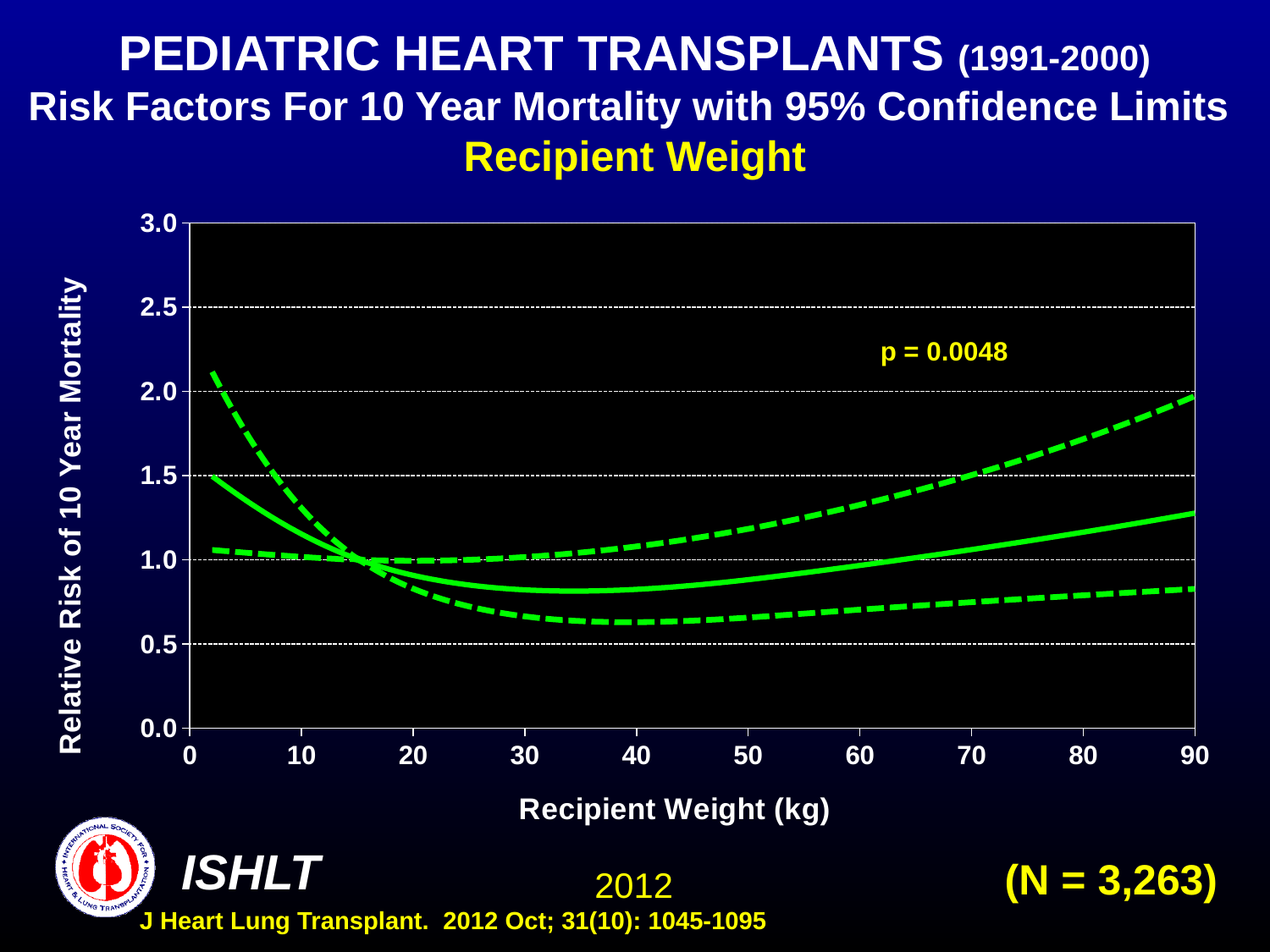
What kind of chart is shown on the slide? line chart Is the relative risk on the solid line at a recipient weight of 90 kg greater or less than 1.0? greater Does the solid relative risk line rise or fall as recipient weight increases from 40 to 90 kg? rise How many lines are plotted on the chart? 3 Is the lower dashed confidence limit at a recipient weight of 40 kg greater or less than 0.5? greater What is the label of the x axis? Recipient Weight (kg) Does the solid relative risk line rise or fall as recipient weight increases from 0 to 40 kg? fall What is the highest value shown on the y axis? 3.0 Is the relative risk on the solid line at a recipient weight of 40 kg greater or less than 1.0? less What p-value is printed on the chart? p = 0.0048